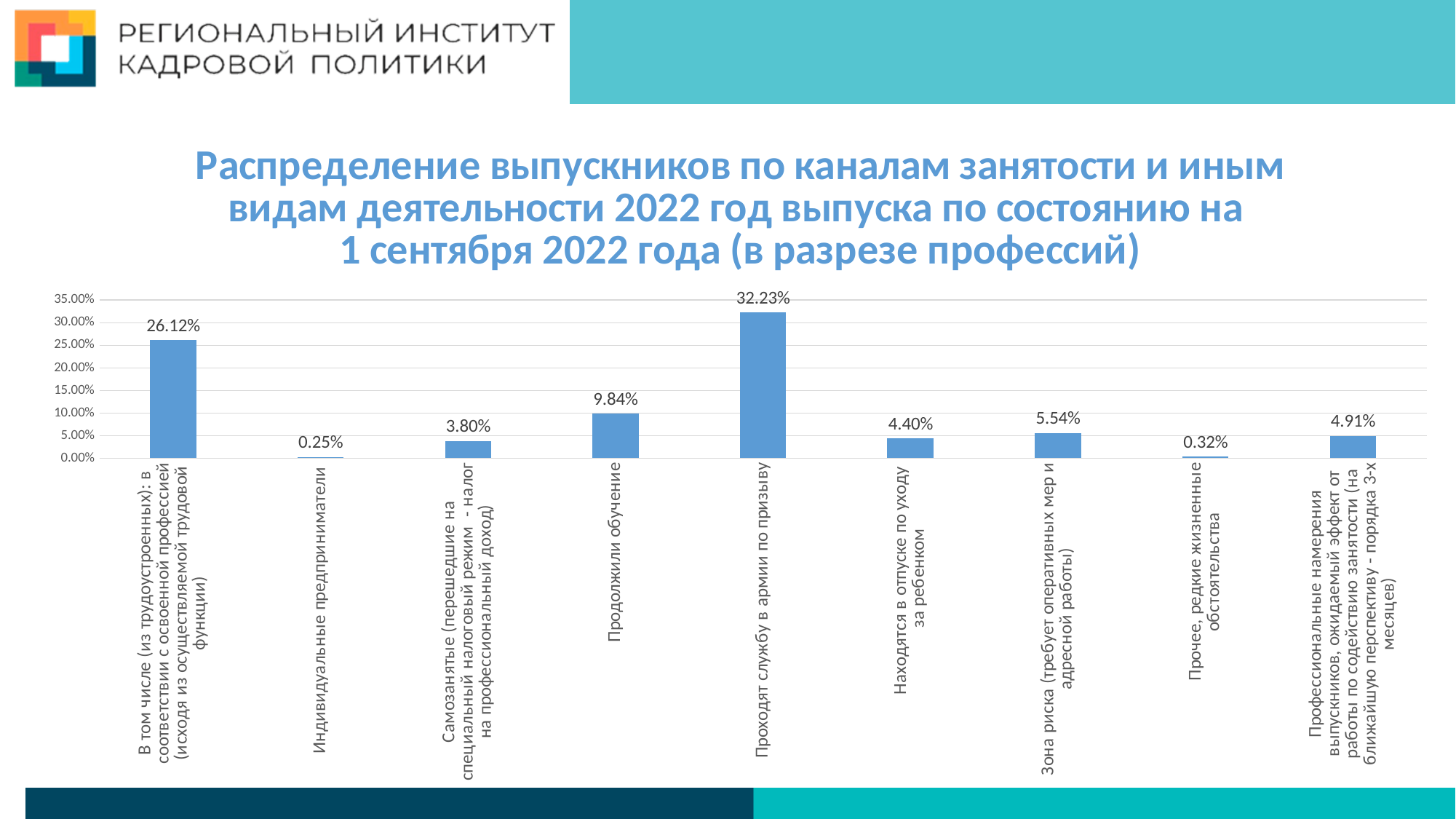
What is the difference between the values for "Проходят службу в армии по призыву" and "В том числе (из трудоустроенных): в соответствии с освоенной профессией"? 6.11% What is the difference between the values for "Продолжили обучение" and "Самозанятые"? 6.04% Which category has the highest value on the chart? Проходят службу в армии по призыву Which category has the lowest value on the chart? Индивидуальные предприниматели What value is shown for "Продолжили обучение"? 9.84% How many categories are shown on the chart? 9 Which is larger: the value for "Зона риска" or the value for "Находятся в отпуске по уходу за ребенком"? Зона риска What value is shown for "Индивидуальные предприниматели"? 0.25% What value is shown for "Зона риска (требует оперативных мер и адресной работы)"? 5.54% What type of chart is shown on the slide? Bar chart Is the value for "Продолжили обучение" greater or less than 5.00%? greater What percentage of graduates are shown as "Проходят службу в армии по призыву"? 32.23%